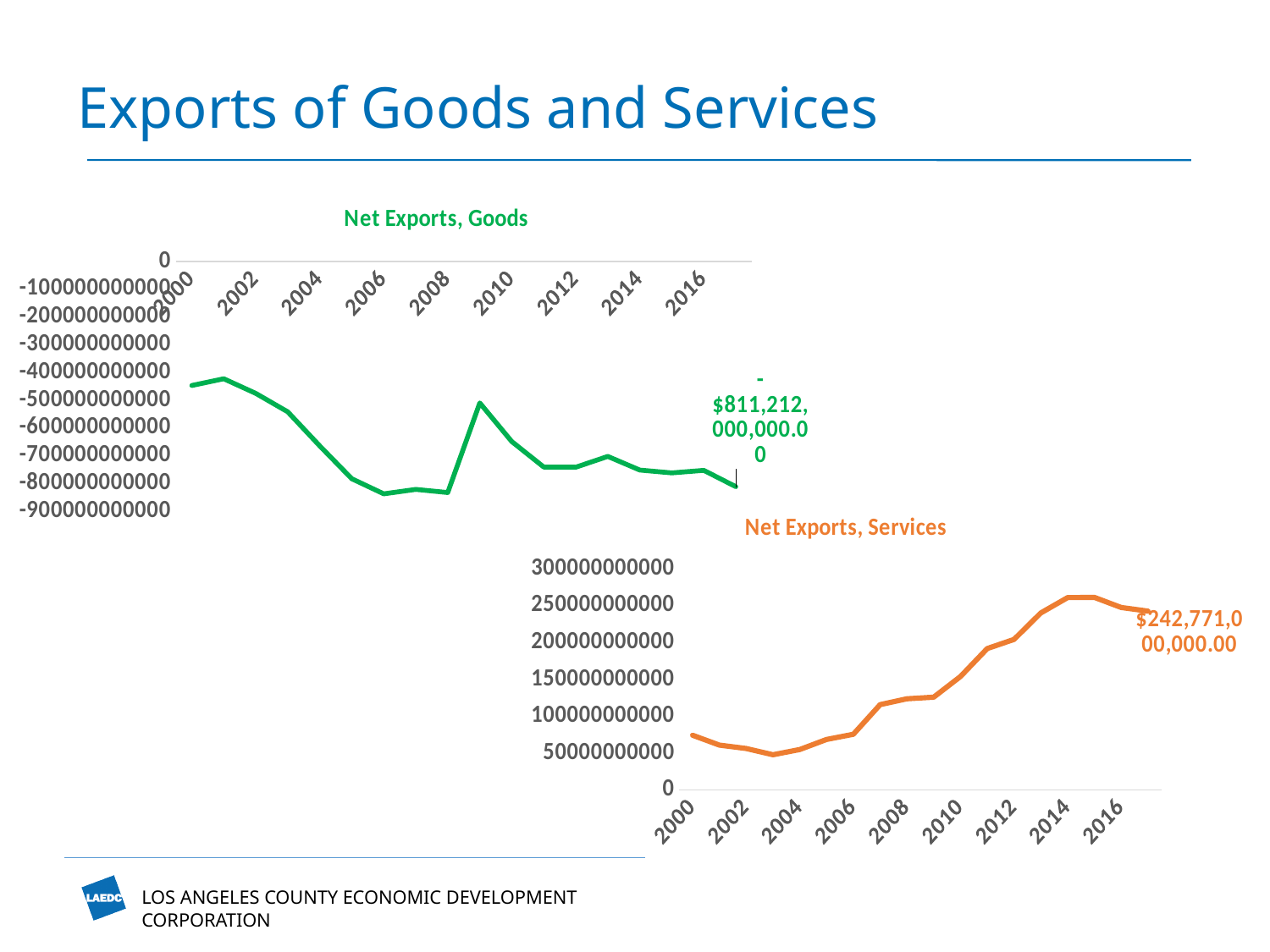
How many charts are shown on the slide? 2 On the Net Exports, Goods chart, is the value for 2000 greater or less than -500000000000? greater On the Net Exports, Goods chart, is the value for 2007 greater or less than -800000000000? less On the Net Exports, Services chart, do the values generally rise or fall from 2000 to 2016? rise On the Net Exports, Goods chart, what is the labeled value for the final data point (2016)? -$811,212,000,000.00 On the Net Exports, Services chart, what is the labeled value for the final data point (2016)? $242,771,000,000.00 On the Net Exports, Services chart, which is larger, the value for 2014 or the value for 2004? 2014 What kind of chart is the Net Exports, Services chart? line chart What kind of chart is the Net Exports, Goods chart? line chart On the Net Exports, Goods chart, do the values generally rise or fall from 2000 to 2016? fall On the Net Exports, Services chart, is the value for 2008 greater or less than 100000000000? greater